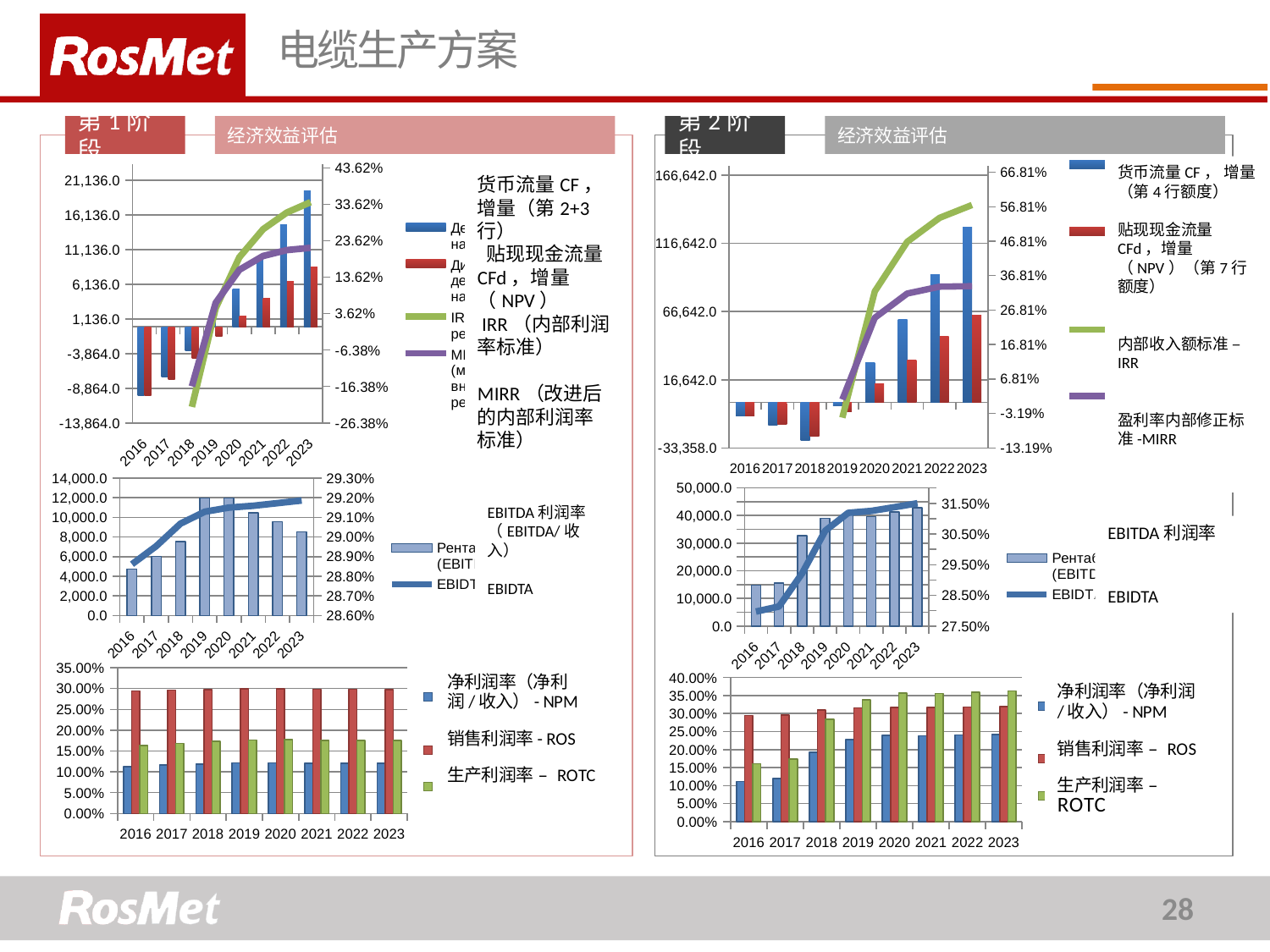
In the Stage 1 (第 1 阶段) bottom-left profitability chart, how many years are shown on the x axis? 8 In the Stage 1 (第 1 阶段) bottom-left profitability chart, which series has the highest value in 2016? 销售利润率 - ROS In the Stage 2 (第 2 阶段) top-right cash flow chart, how many series does the legend list? 4 What kind of chart is the Stage 2 (第 2 阶段) bottom-right profitability chart? bar chart In the Stage 1 (第 1 阶段) middle-left EBITDA chart, is the 2016 bar greater or less than 6,000.0? less In the Stage 2 (第 2 阶段) top-right cash flow chart, which year has the tallest blue bar? 2023 In the Stage 1 (第 1 阶段) middle-left EBITDA chart, which year has the lowest bar? 2016 In the Stage 2 (第 2 阶段) bottom-right profitability chart, which series has the highest value in 2023? 生产利润率 – ROTC In the Stage 2 (第 2 阶段) middle-right EBITDA chart, does the EBITDA margin line generally rise or fall from 2016 to 2023? rise In the Stage 1 (第 1 阶段) bottom-left profitability chart, is the 2016 value for 净利润率 (NPM) greater or less than 15.00%? less In the Stage 1 (第 1 阶段) bottom-left profitability chart, how many series does the legend list? 3